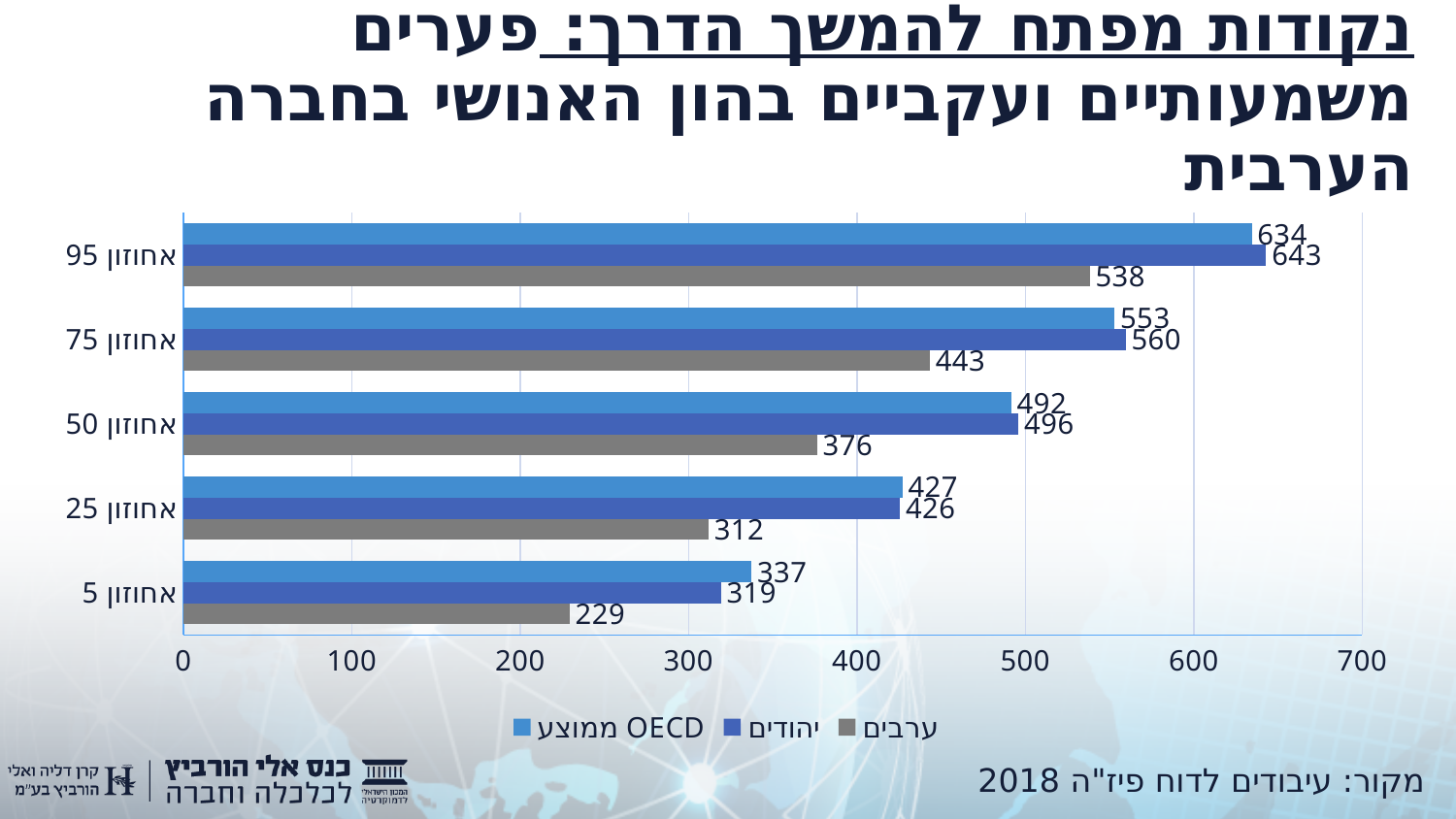
At אחוזון 5, which is larger: the value for ממוצע OECD or the value for יהודים? ממוצע OECD How many series does the legend list? 3 What is the difference between the יהודים and ערבים values at אחוזון 75? 117 Which series is shown in gray? ערבים What is the value for ערבים at אחוזון 95? 538 What is the value for ערבים at אחוזון 25? 312 What is the value for ממוצע OECD at אחוזון 5? 337 Which category has the highest value for ערבים? אחוזון 95 How many categories are shown on the chart? 5 What is the value for יהודים at אחוזון 50? 496 Which category has the lowest value for יהודים? אחוזון 5 What kind of chart is shown on the slide? bar chart